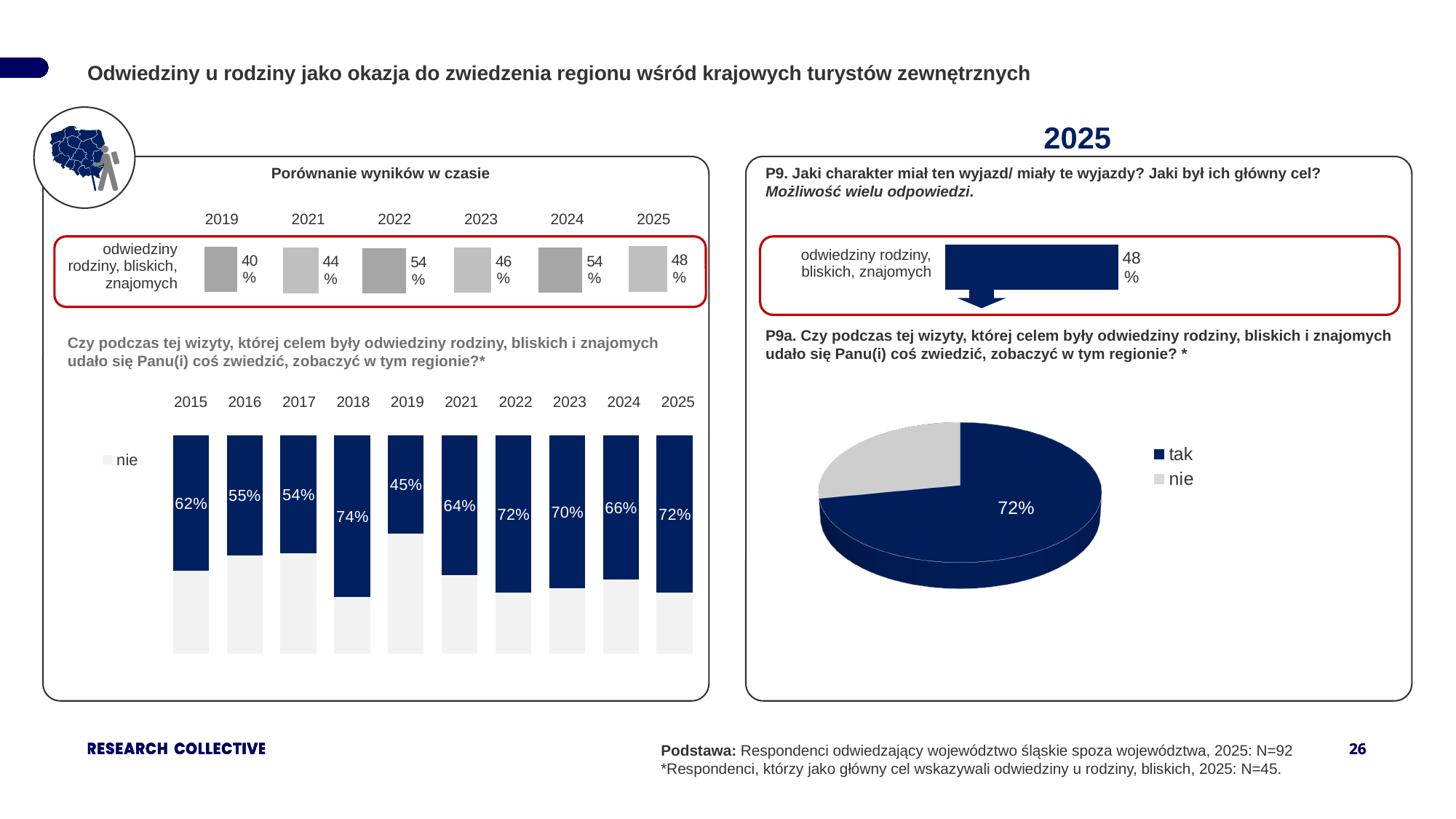
In the 'Porównanie wyników w czasie' chart at the top left, which year has the lowest value? 2019 In the 'Porównanie wyników w czasie' chart at the top left, how many years are shown? 6 In the stacked bar chart at the bottom left, which year has the highest 'tak' value? 2018 In the 'Porównanie wyników w czasie' chart at the top left, what is the value for 2022? 54% In the 'Porównanie wyników w czasie' chart at the top left, what is the difference between the 2024 value and the 2025 value? 6% In the 'Porównanie wyników w czasie' chart at the top left, what is the value for 2019? 40% In the pie chart on the right, what share of respondents answered 'tak'? 72% In the stacked bar chart at the bottom left, is the 'tak' value for 2022 larger or smaller than for 2023? larger In the stacked bar chart at the bottom left, what is the 'tak' value for 2018? 74% What type of chart is shown at the bottom right of the slide? pie chart In the stacked bar chart at the bottom left, how many years are shown? 10 In the stacked bar chart at the bottom left, which year has the lowest 'tak' value? 2019